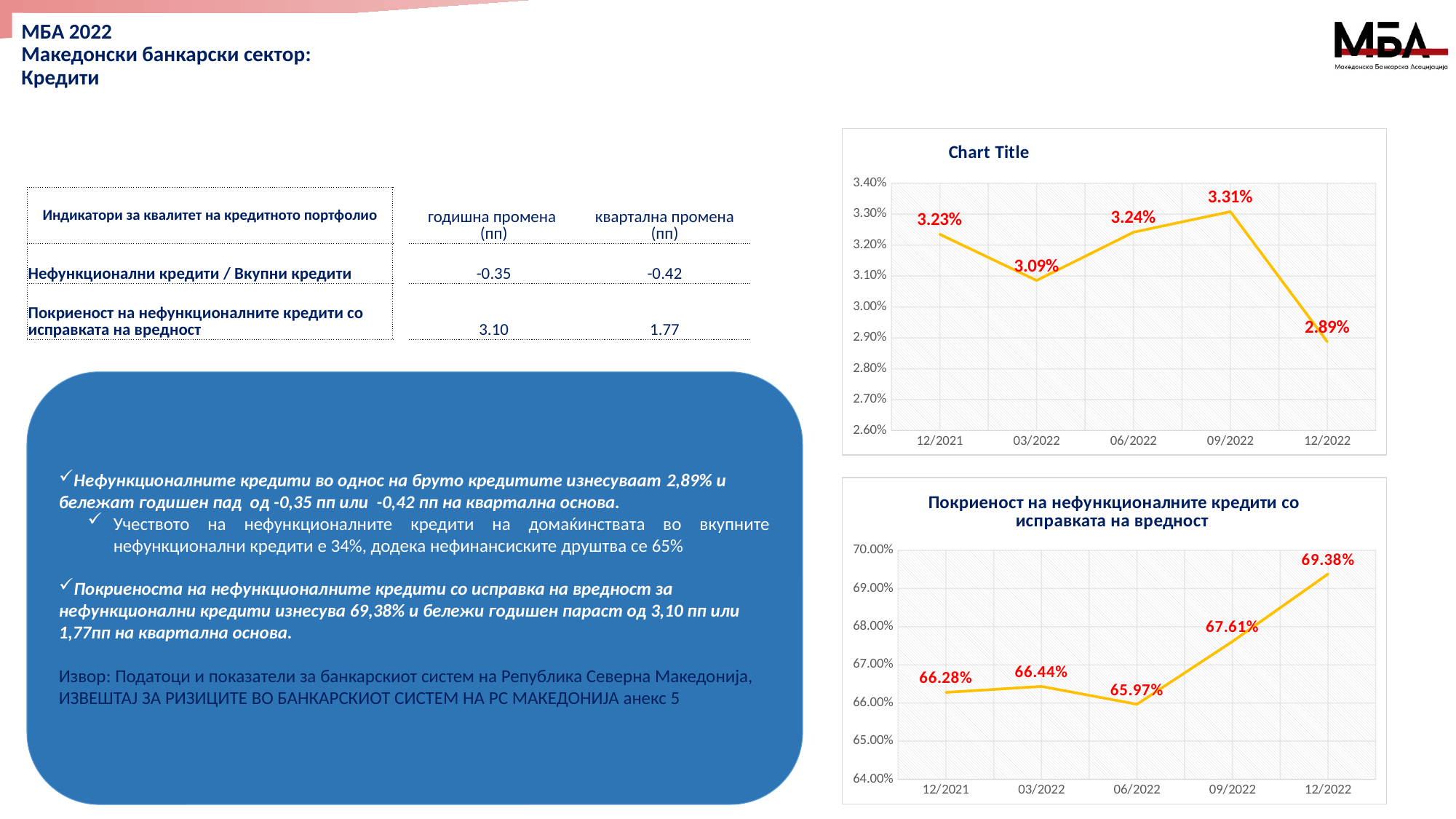
In the top-right chart (titled "Chart Title"), what is the difference between the values for 09/2022 and 12/2022? 0.42% In the bottom-right chart (Покриеност на нефункционалните кредити со исправката на вредност), do the values rise or fall from 06/2022 to 12/2022? Rise In the top-right chart (titled "Chart Title"), what is the value for 12/2022? 2.89% In the bottom-right chart (Покриеност на нефункционалните кредити со исправката на вредност), which is larger: the value for 12/2021 or the value for 03/2022? 03/2022 In the bottom-right chart (Покриеност на нефункционалните кредити со исправката на вредност), what is the value for 06/2022? 65.97% In the bottom-right chart (Покриеност на нефункционалните кредити со исправката на вредност), which period has the lowest value? 06/2022 What type of chart is the top-right chart (titled "Chart Title")? Line chart In the top-right chart (titled "Chart Title"), which period has the highest value? 09/2022 In the bottom-right chart (Покриеност на нефункционалните кредити со исправката на вредност), which period has the highest value? 12/2022 In the top-right chart (titled "Chart Title"), which period has the lowest value? 12/2022 In the bottom-right chart (Покриеност на нефункционалните кредити со исправката на вредност), what is the difference between the values for 12/2022 and 12/2021? 3.10% In the top-right chart (titled "Chart Title"), how many data points are plotted? 5